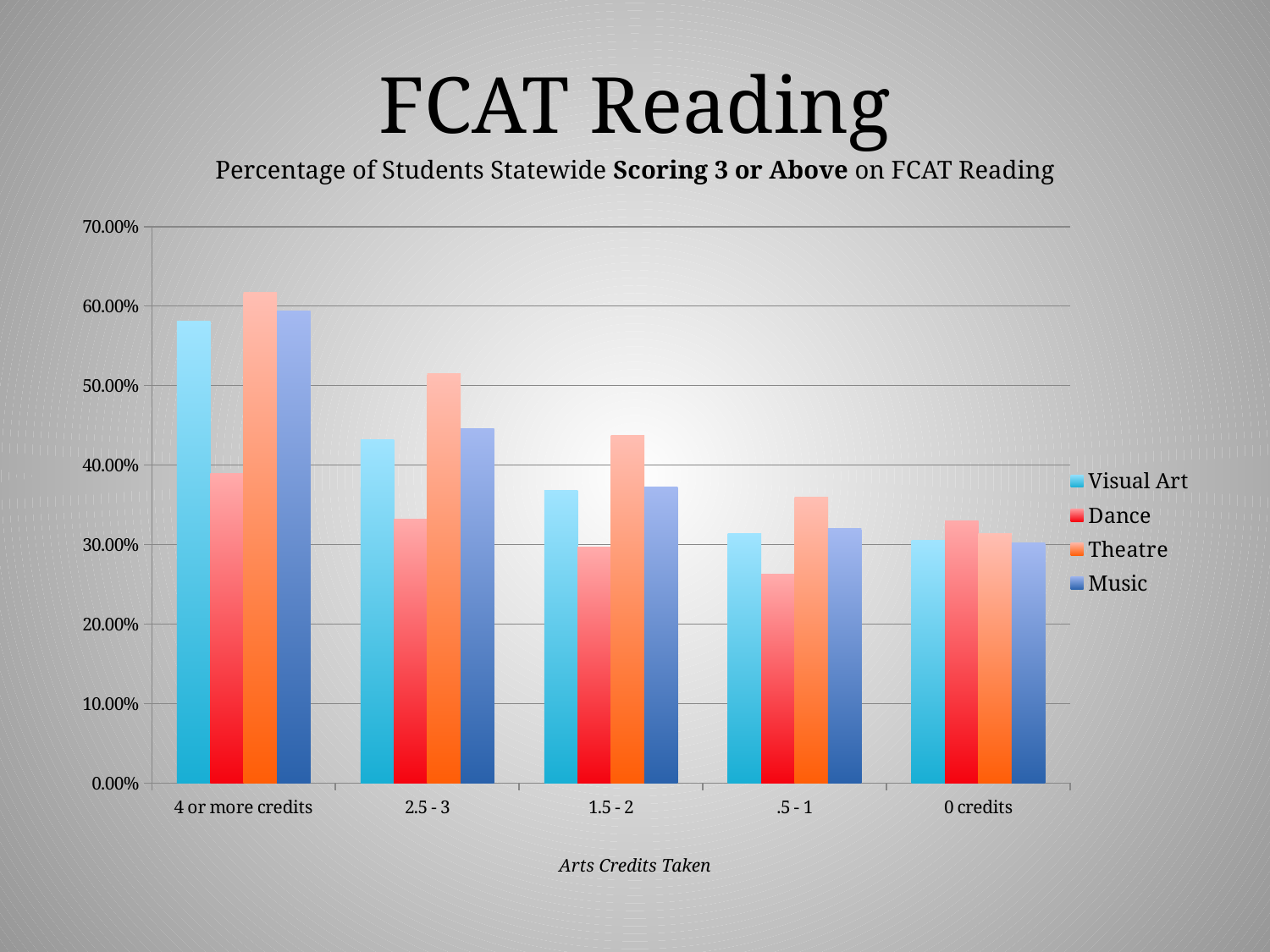
How many series does the legend list? 4 How many categories are shown along the x axis? 5 What is the title of the x axis? Arts Credits Taken In the '2.5 - 3' category, which is larger: Theatre or Visual Art? Theatre Which series has the lowest value in the '4 or more credits' category? Dance For which category is the Theatre value highest? 4 or more credits In the '1.5 - 2' category, which is larger: Dance or Music? Music Is the Theatre value for '4 or more credits' greater or less than 60.00%? greater Do the Theatre values rise or fall moving from '4 or more credits' to '0 credits' along the x axis? fall What kind of chart is shown on the slide? bar chart Is the Dance value for '.5 - 1' greater or less than 30.00%? less Is the Visual Art value for '4 or more credits' greater or less than 50.00%? greater